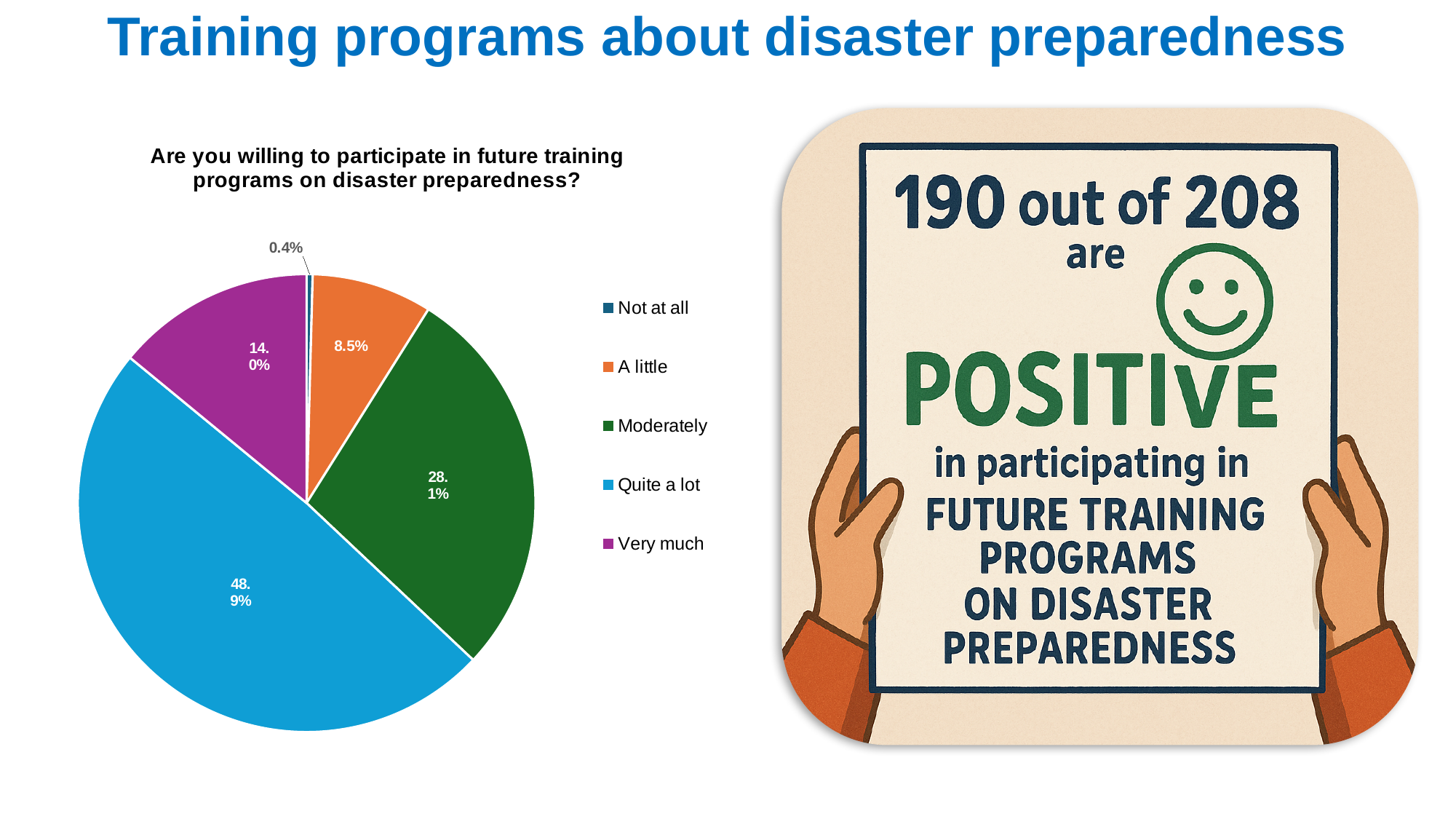
What percentage of respondents answered "Very much"? 14.0% Which response category has the largest share of the pie? Quite a lot Which response category has the smallest share of the pie? Not at all What percentage of respondents answered "Moderately"? 28.1% Which is larger, the share for "Very much" or the share for "A little"? Very much What is the title of the pie chart? Are you willing to participate in future training programs on disaster preparedness? What kind of chart is shown on the slide? Pie chart How many response categories does the pie chart show? 5 What percentage of respondents answered "Not at all"? 0.4% What percentage of respondents answered "Quite a lot"? 48.9% What is the difference in percentage points between "Quite a lot" and "Moderately"? 20.8 What percentage of respondents answered "A little"? 8.5%